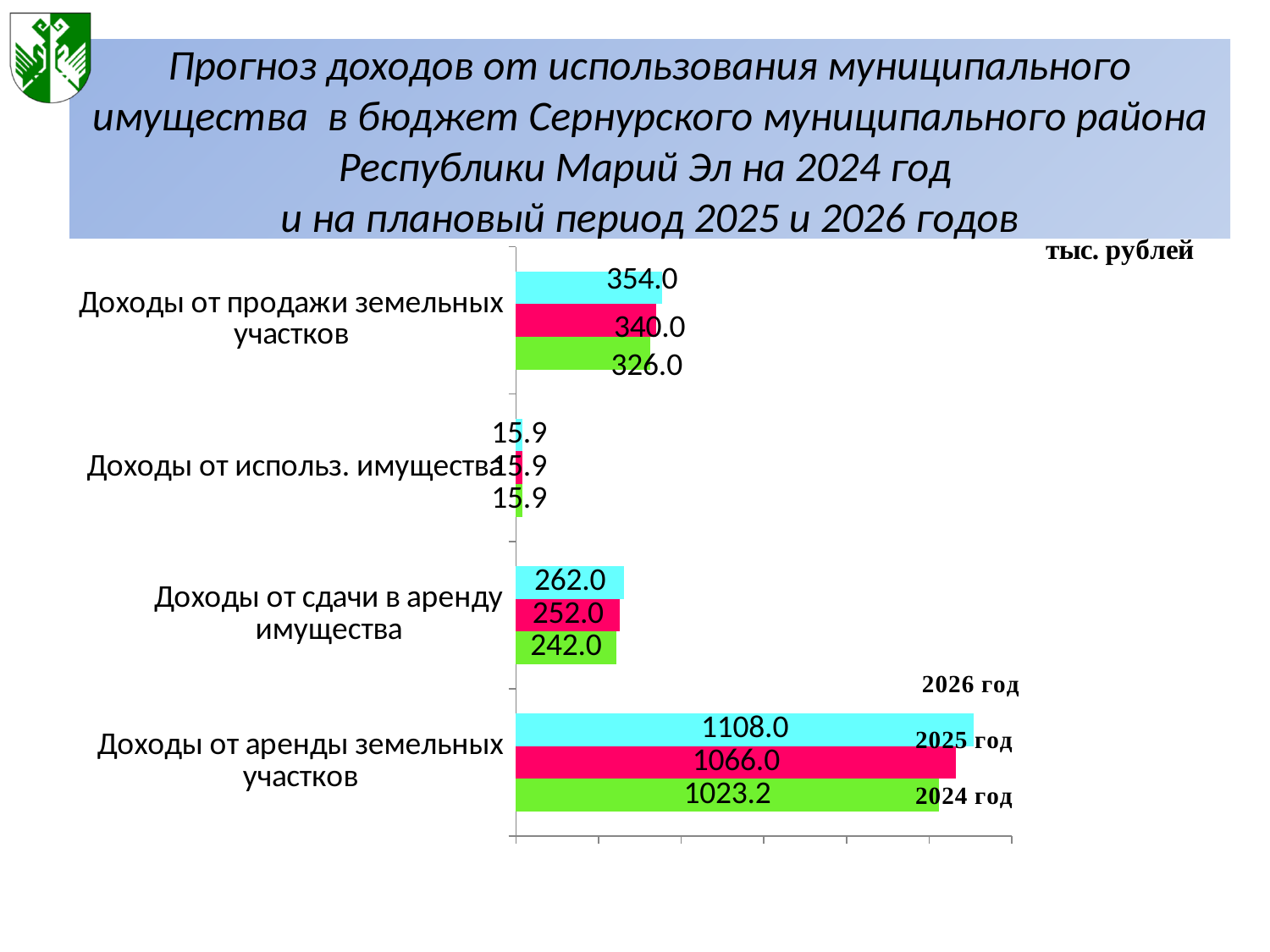
What is the value for 'Доходы от продажи земельных участков' in 2025 год? 340.0 What kind of chart is shown on the slide? bar chart Which category has the highest value in 2026 год? Доходы от аренды земельных участков How many categories are shown on the chart? 4 Which is larger for 'Доходы от сдачи в аренду имущества': the 2025 год value or the 2026 год value? 2026 год What is the value for 'Доходы от сдачи в аренду имущества' in 2024 год? 242.0 What is the value for 'Доходы от аренды земельных участков' in 2024 год? 1023.2 What is the value for 'Доходы от аренды земельных участков' in 2026 год? 1108.0 What is the value for 'Доходы от использ. имущества' in 2026 год? 15.9 What is the difference between the 2026 год and 2024 год values for 'Доходы от продажи земельных участков'? 28.0 Which category has the lowest value in 2024 год? Доходы от использ. имущества How many series (years) does the chart show? 3